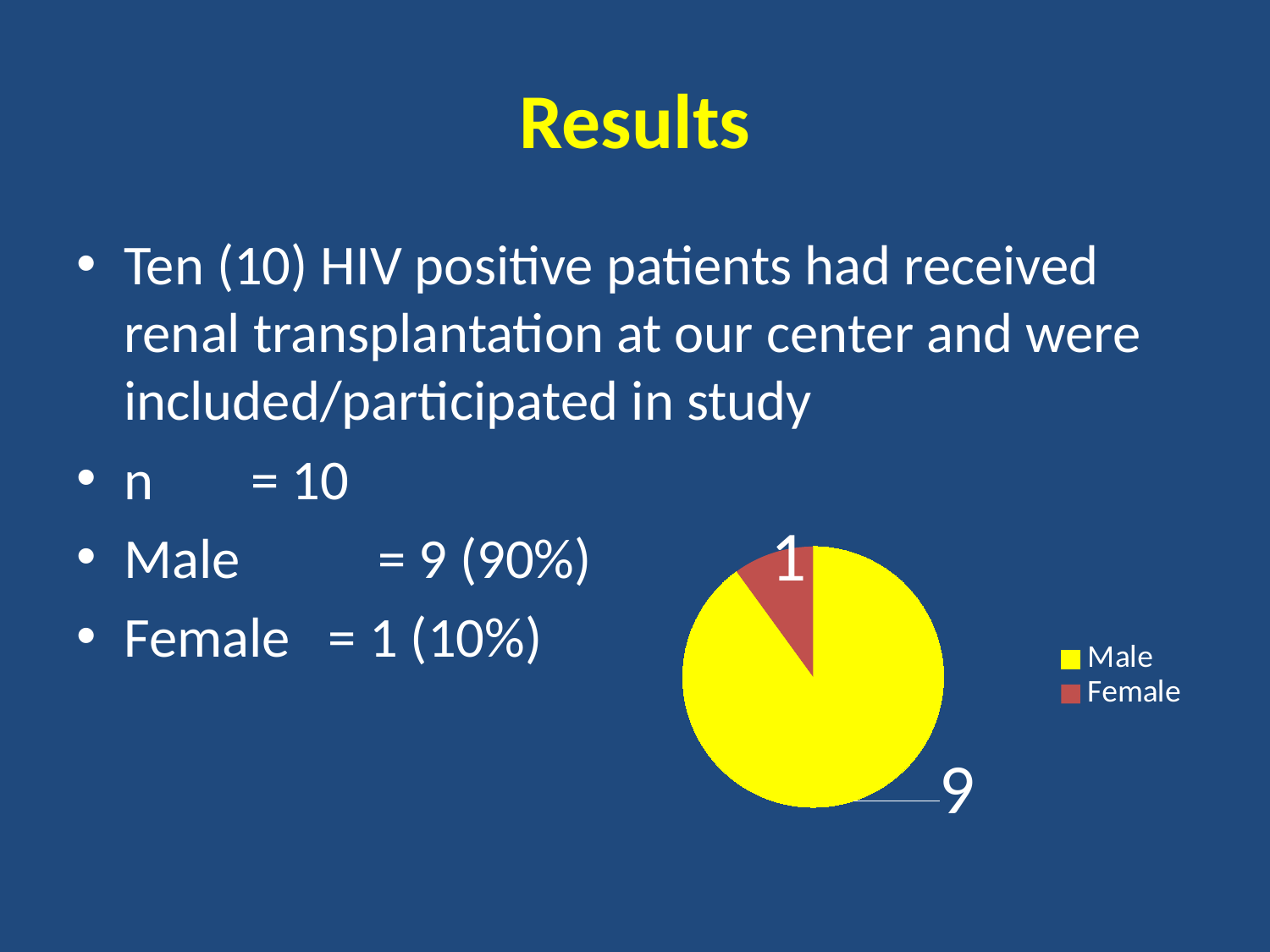
How many categories does the pie chart show? 2 What kind of chart is shown on the slide? pie chart Which is larger in the pie chart, Male or Female? Male What is the total of all slices in the pie chart? 10 What is the value for Male in the pie chart? 9 Which category has the largest slice in the pie chart? Male What colour is the Female slice in the pie chart? red What is the difference between the Male and Female values in the pie chart? 8 How many entries does the legend of the pie chart list? 2 Which category has the smallest slice in the pie chart? Female What share of the pie does the Male slice represent? 90% What is the value for Female in the pie chart? 1